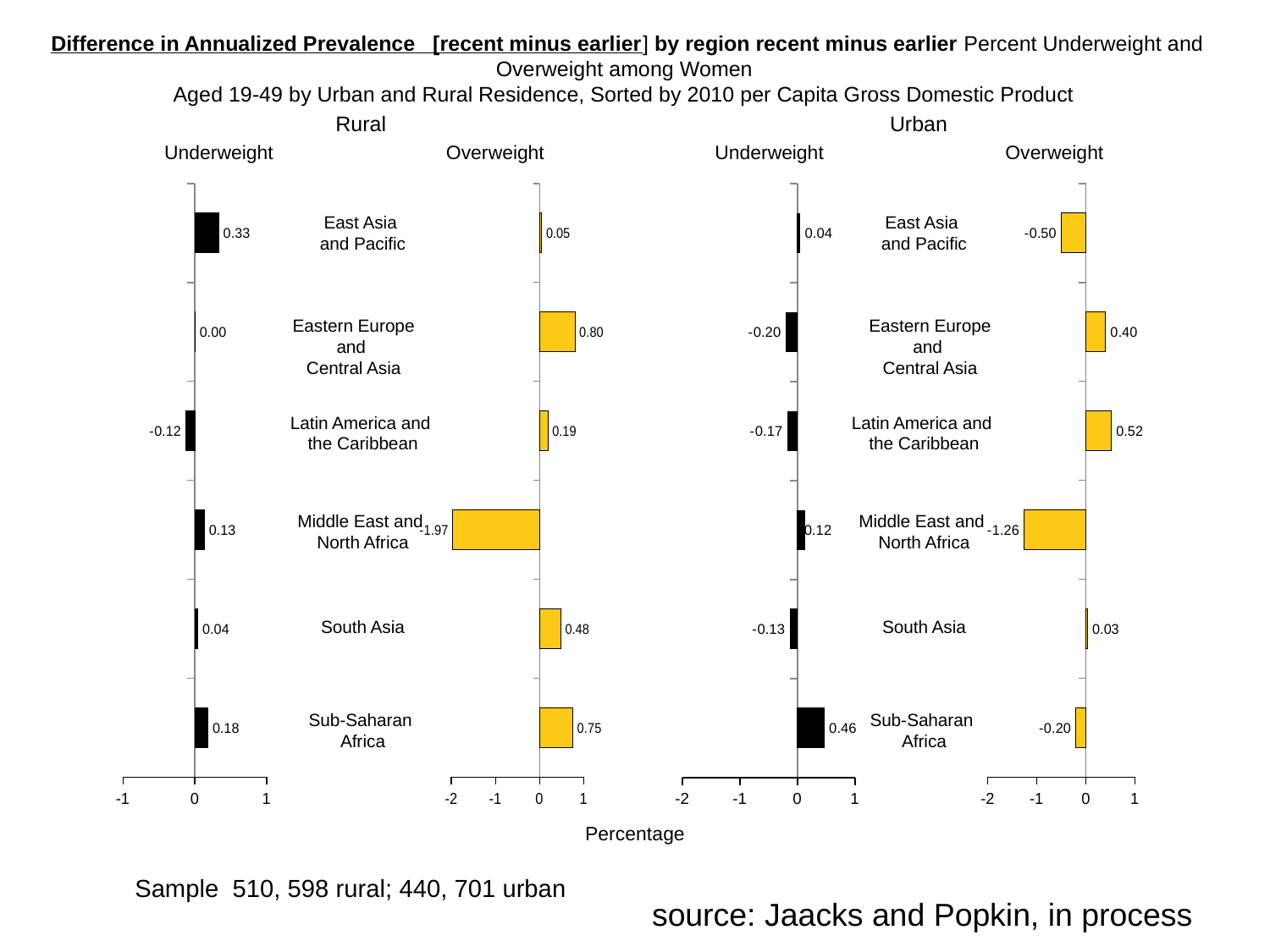
In the Urban Underweight chart, what is the value for Sub-Saharan Africa? 0.46 In the Rural Overweight chart, what is the value for Middle East and North Africa? -1.97 In the Rural Overweight chart, which region has the highest value? Eastern Europe and Central Asia In the Urban Overweight chart, what is the value for Latin America and the Caribbean? 0.52 In the Rural Underweight chart, which is larger: the value for East Asia and Pacific or the value for Sub-Saharan Africa? East Asia and Pacific What kind of chart is the Rural Underweight chart? Bar chart In the Rural Overweight chart, what is the difference between the values for Eastern Europe and Central Asia and Sub-Saharan Africa? 0.05 How many regions are shown in the Urban Overweight chart? 6 In the Urban Overweight chart, which region has the lowest value? Middle East and North Africa What is the label on the shared horizontal axis at the bottom of the charts? Percentage In the Rural Underweight chart, what is the value for East Asia and Pacific? 0.33 In the Urban Underweight chart, which region has the lowest value? Eastern Europe and Central Asia